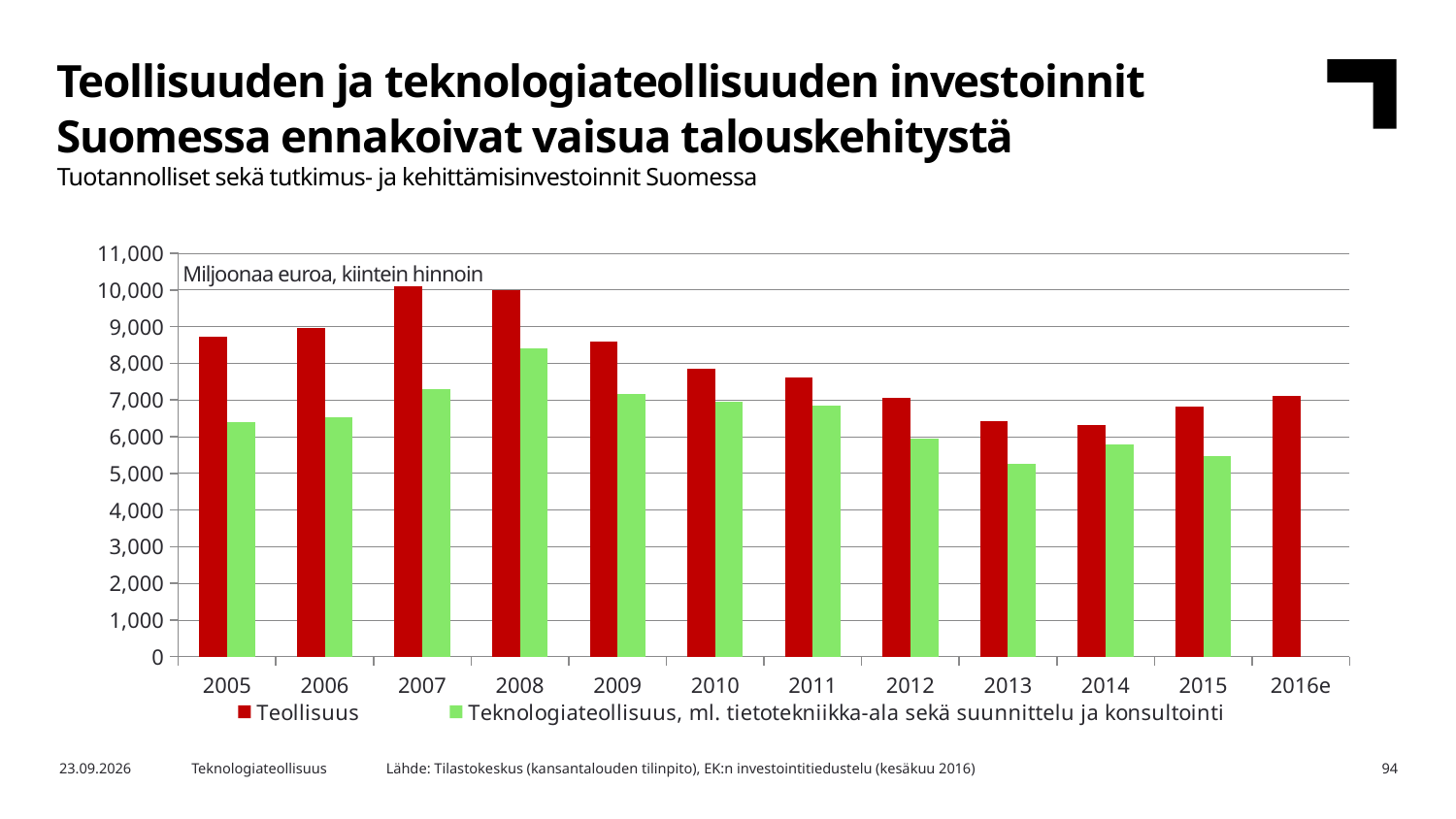
Is the value for Teollisuus in 2005 greater or less than 8,000? greater In which year is the value for Teknologiateollisuus highest? 2008 In 2008, which series has the larger value, Teollisuus or Teknologiateollisuus? Teollisuus Is the value for Teollisuus in 2010 greater or less than 7,000? greater How many series does the legend list? 2 In which year is the value for Teknologiateollisuus lowest? 2013 What kind of chart is shown on the slide? Bar chart What unit label is shown inside the chart area? Miljoonaa euroa, kiintein hinnoin Is the value for Teknologiateollisuus in 2013 greater or less than 6,000? less How many year categories are shown on the x axis? 12 Do the values for Teollisuus rise or fall from 2008 to 2014? Fall